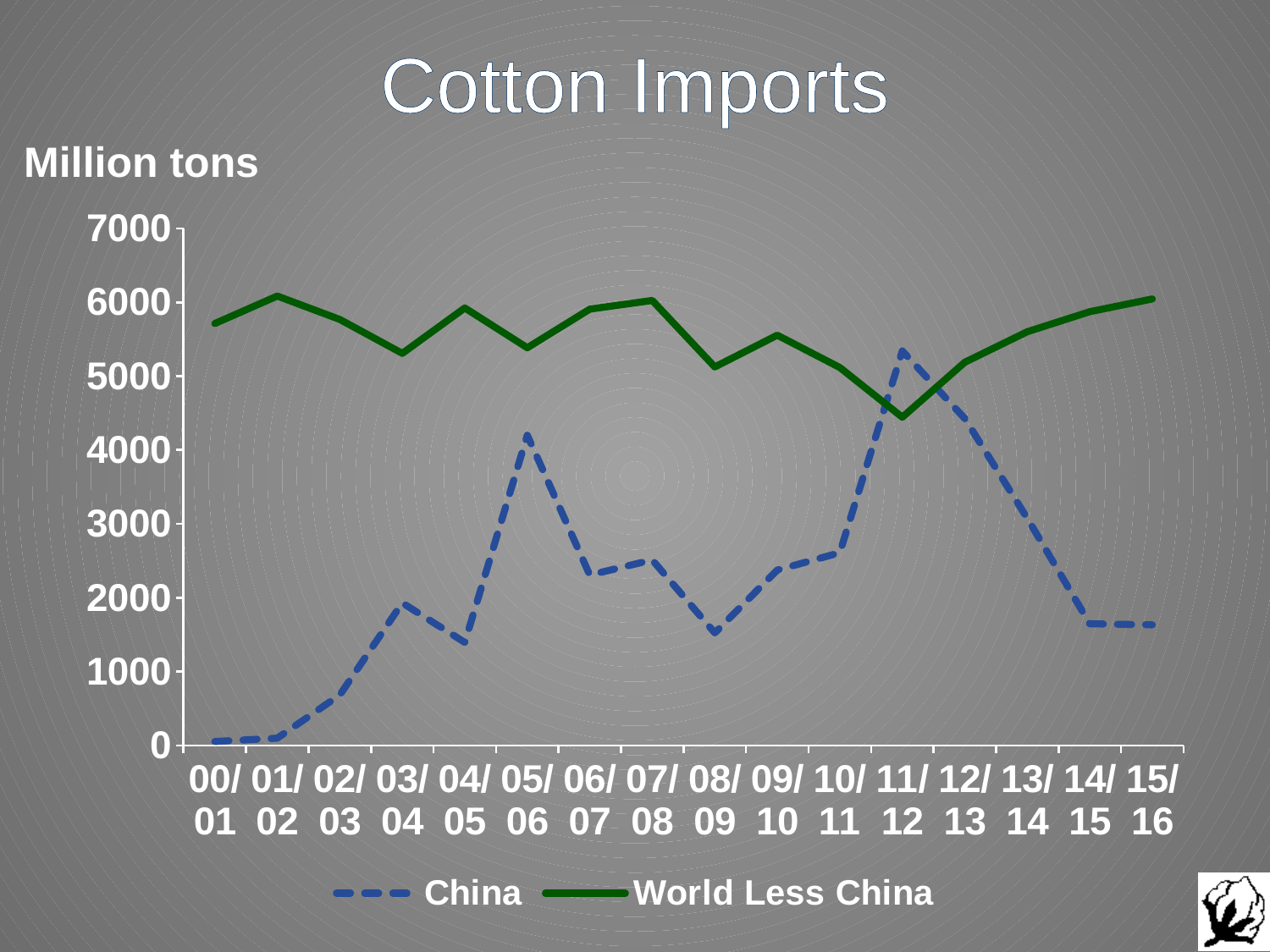
Does the China series rise or fall from 11/12 to 15/16? Fall How many seasons are plotted along the x axis? 16 In 00/01, which series has the larger value, China or World Less China? World Less China Is the value for World Less China in 11/12 greater or less than 5000? less In which season does the China series reach its highest value? 11/12 Is the value for China in 05/06 greater or less than 4000? greater In which season does the World Less China series reach its lowest value? 11/12 What type of chart is shown on the slide? Line chart What unit is shown above the y axis of the chart? Million tons In 11/12, which series has the larger value, China or World Less China? China Is the value for China in 15/16 greater or less than 2000? less How many series does the legend list? 2